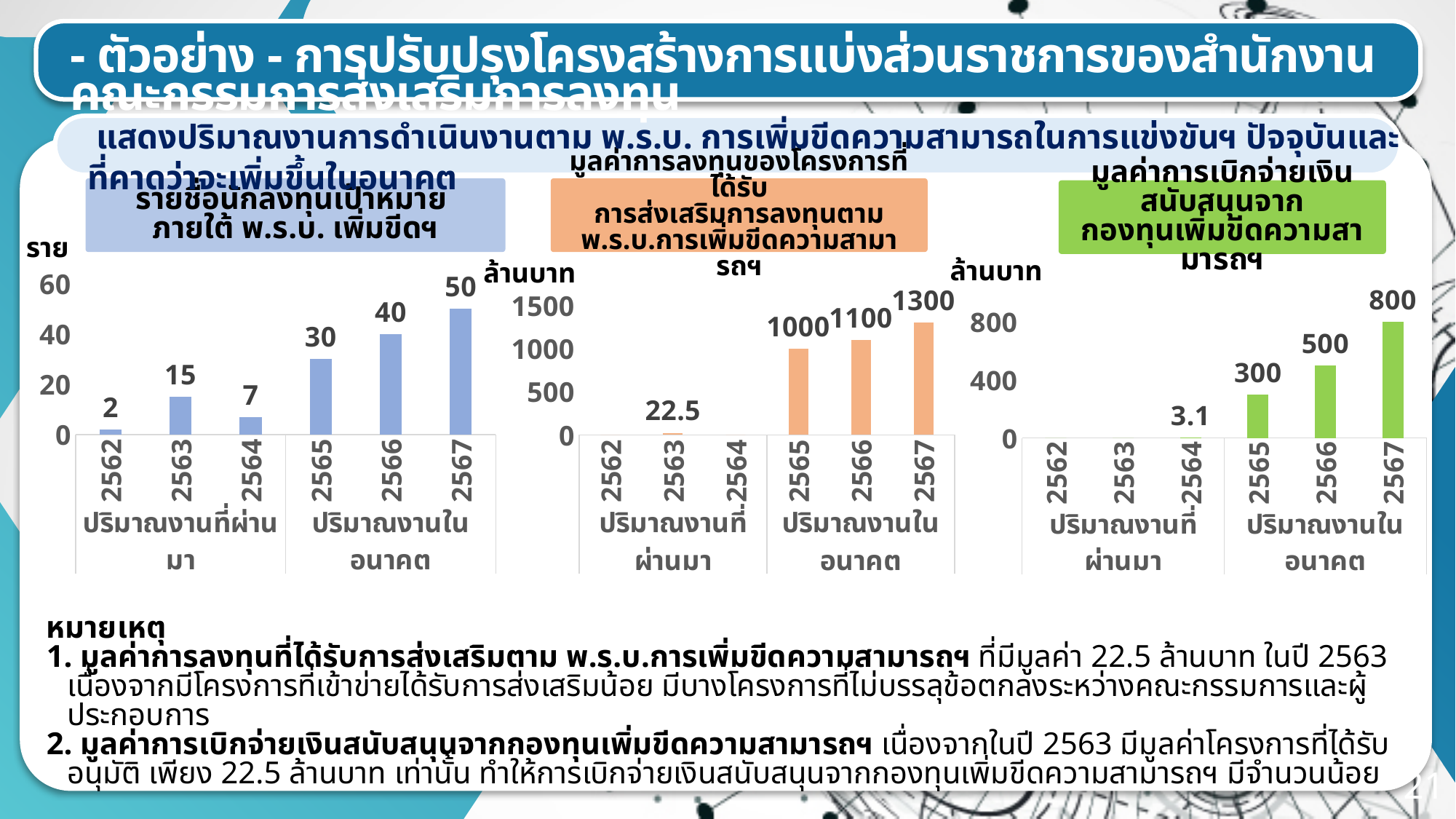
In the left chart, what is the difference between the values for 2567 and 2565? 20 In the middle chart, which year has the highest value? 2567 What type of chart is the right chart? bar chart In the middle chart, what is the value for 2563? 22.5 In the right chart, do the values rise or fall from 2565 to 2567? rise In the right chart, which is larger, the value for 2566 or the value for 2565? 2566 In the left chart, what is the value for 2563? 15 In the right chart, what is the value for 2564? 3.1 In the middle chart, what is the difference between the values for 2567 and 2566? 200 What unit is shown on the y axis of the middle chart? ล้านบาท In the left chart, which year has the lowest value? 2562 In the left chart, what is the value for 2567? 50